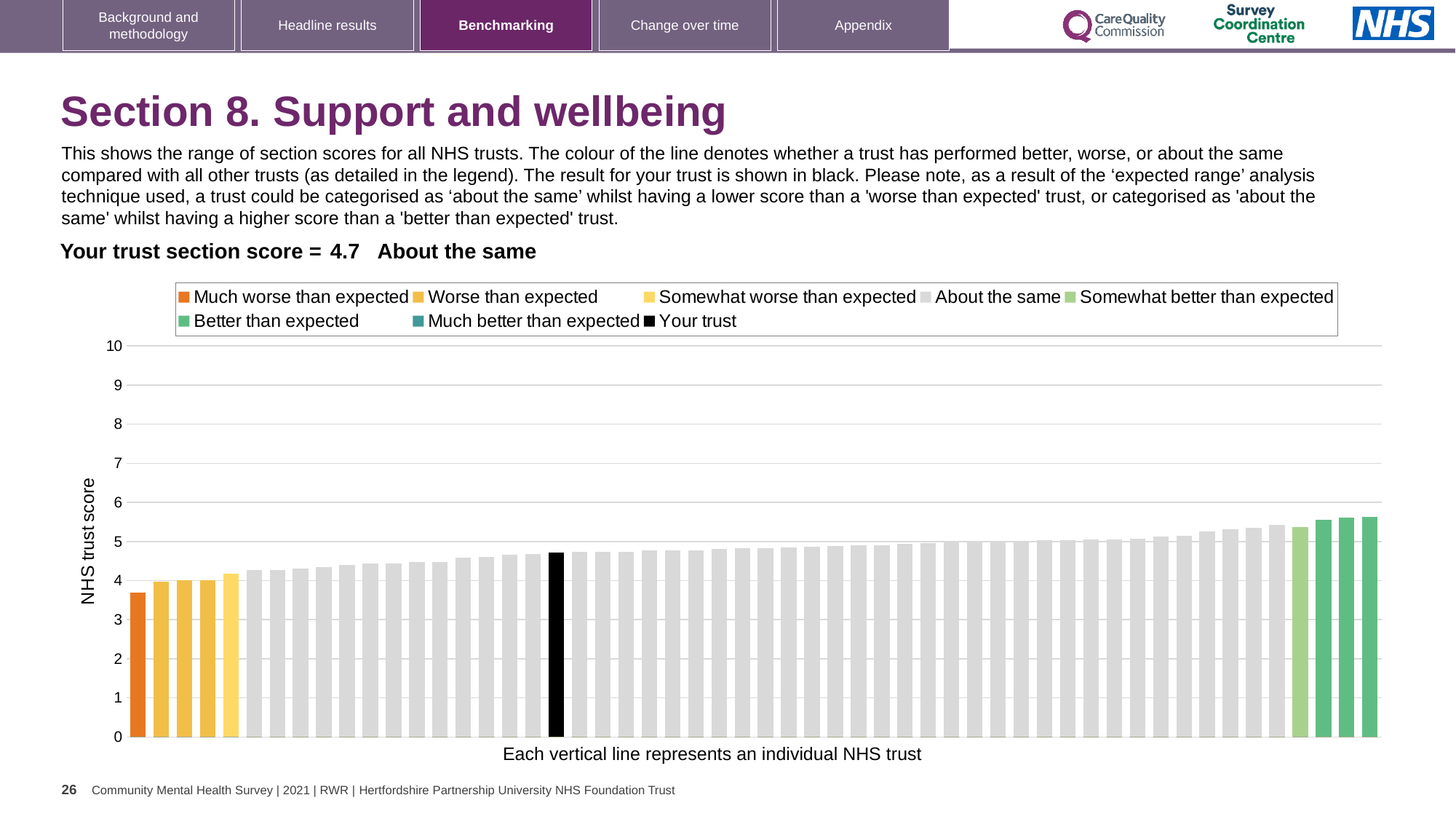
Which is larger: the value of the black bar or the value of the leftmost orange bar? the black bar Is the value of the orange bar (much worse than expected) greater or less than 4? less What is the section score for your trust shown on the chart? 4.7 Which legend category does the highest bar on the chart belong to? Better than expected How many entries does the chart legend list? 8 What kind of chart is shown on the slide? bar chart What is the label on the vertical axis of the chart? NHS trust score Is the value of the rightmost bar greater or less than 5? greater Do the bar values rise or fall from left to right along the x axis? rise What colour is used for the bar representing your trust? black Which legend category does the lowest bar on the chart belong to? Much worse than expected Is the value of the black bar (your trust) greater or less than 5? less